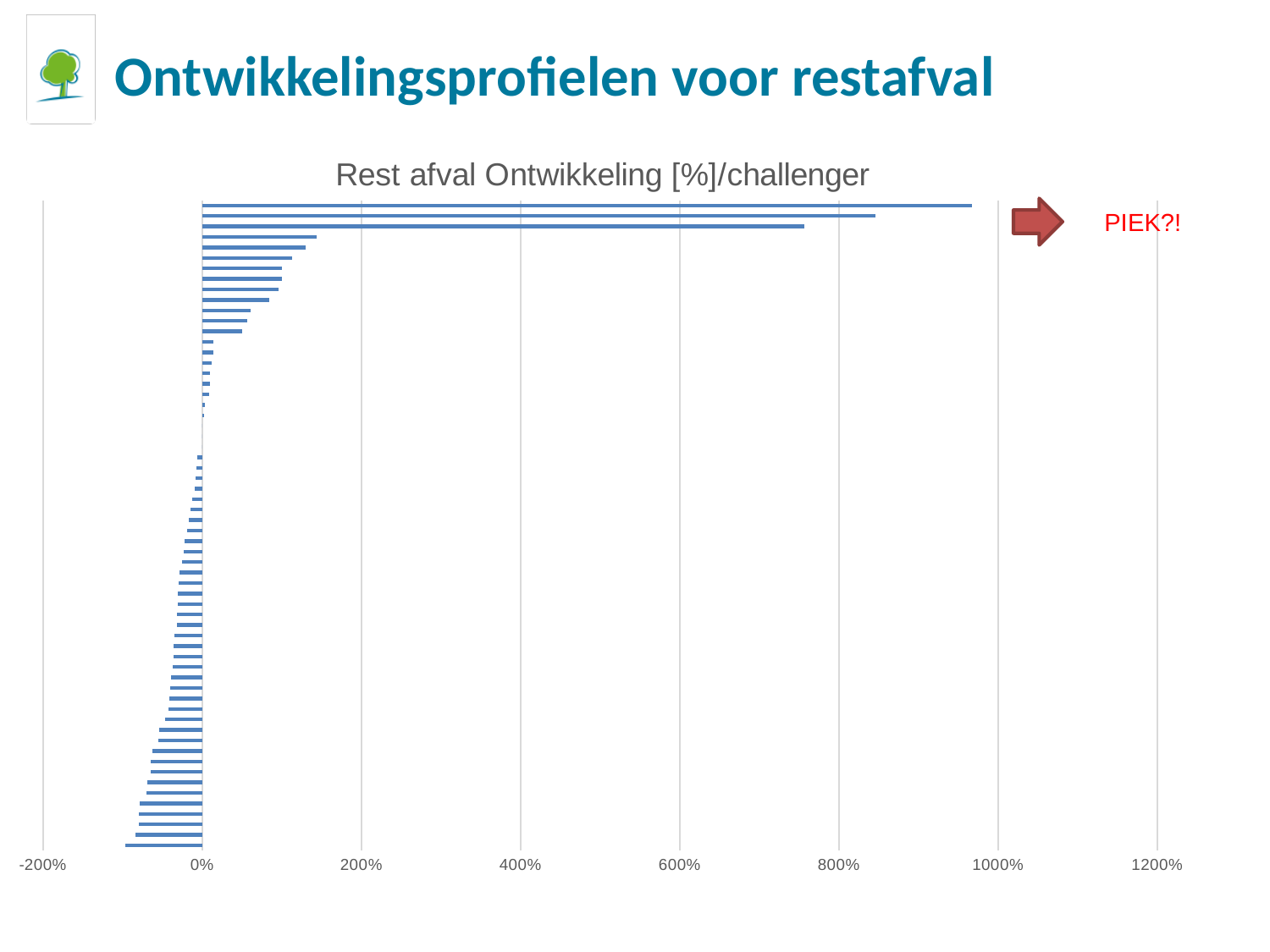
What is the highest value label shown on the horizontal axis? 1200% Is the value of the longest bar greater or less than 800%? greater Is the value of the third bar from the top greater or less than 600%? greater What is the title of the chart? Rest afval Ontwikkeling [%]/challenger How many bars extend beyond 200%? 3 Is the value of the bottom bar greater or less than -200%? greater What kind of chart is shown on the slide? bar chart What is the lowest value label shown on the horizontal axis? -200% How many bars extend beyond 600%? 3 Do the bar values rise or fall going from the top of the chart to the bottom? fall